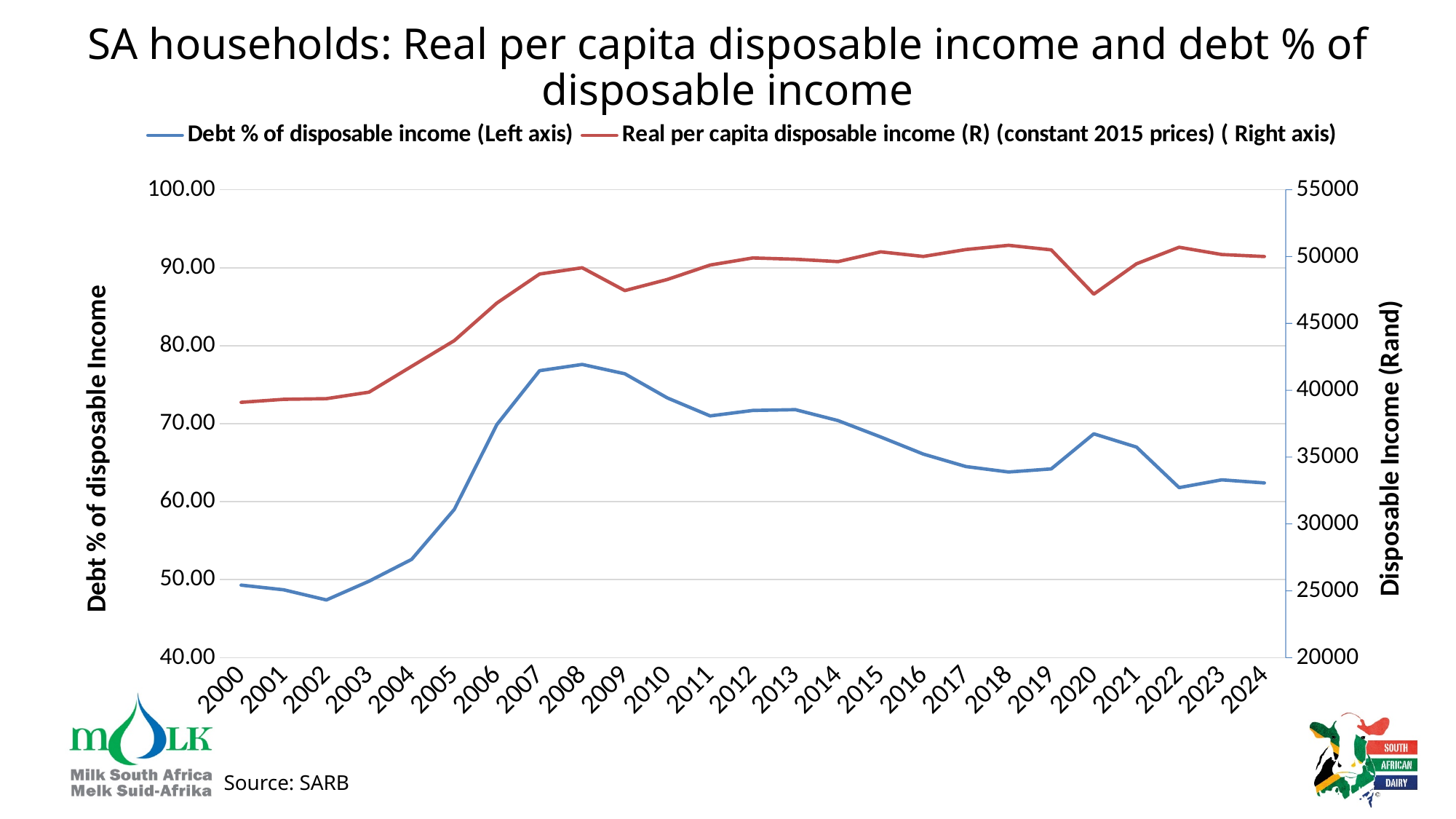
How many series does the legend list? 2 Does the Debt % of disposable income rise or fall from 2013 to 2018? Fall In which year is Debt % of disposable income at its highest? 2008 Is the Real per capita disposable income in 2020 greater or less than 45000? greater Which year has the higher Debt % of disposable income, 2005 or 2015? 2015 What kind of chart is shown on the slide? Line chart How many years are plotted along the x axis? 25 Is the Real per capita disposable income in 2005 greater or less than 45000? less Is the Debt % of disposable income in 2008 greater or less than 70.00? greater What is the title of the right-hand vertical axis? Disposable Income (Rand) In which year is Debt % of disposable income at its lowest? 2002